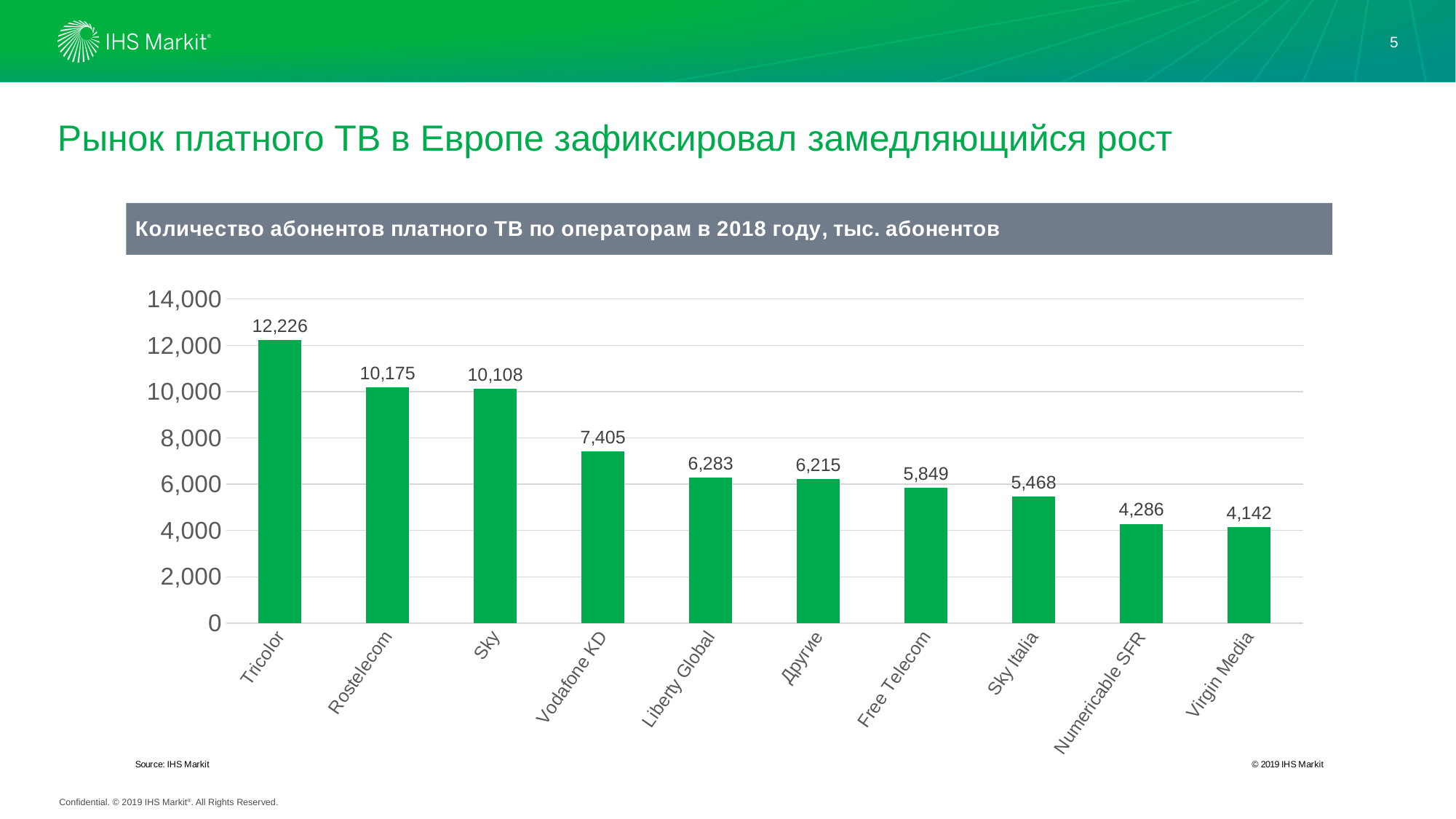
What is the difference between the values for Tricolor and Rostelecom? 2,051 What is the value for Vodafone KD? 7,405 Which operator has the lowest number of subscribers? Virgin Media What kind of chart is shown on the slide? bar chart What is the title of the chart? Количество абонентов платного ТВ по операторам в 2018 году, тыс. абонентов How many operators (categories) are shown in the chart? 10 Which is larger, the value for Liberty Global or the value for Free Telecom? Liberty Global Which operator has the highest number of subscribers? Tricolor What is the value for Tricolor? 12,226 What is the value for Sky Italia? 5,468 Is the value for Sky greater or less than 8,000? greater What is the difference between the values for Numericable SFR and Virgin Media? 144